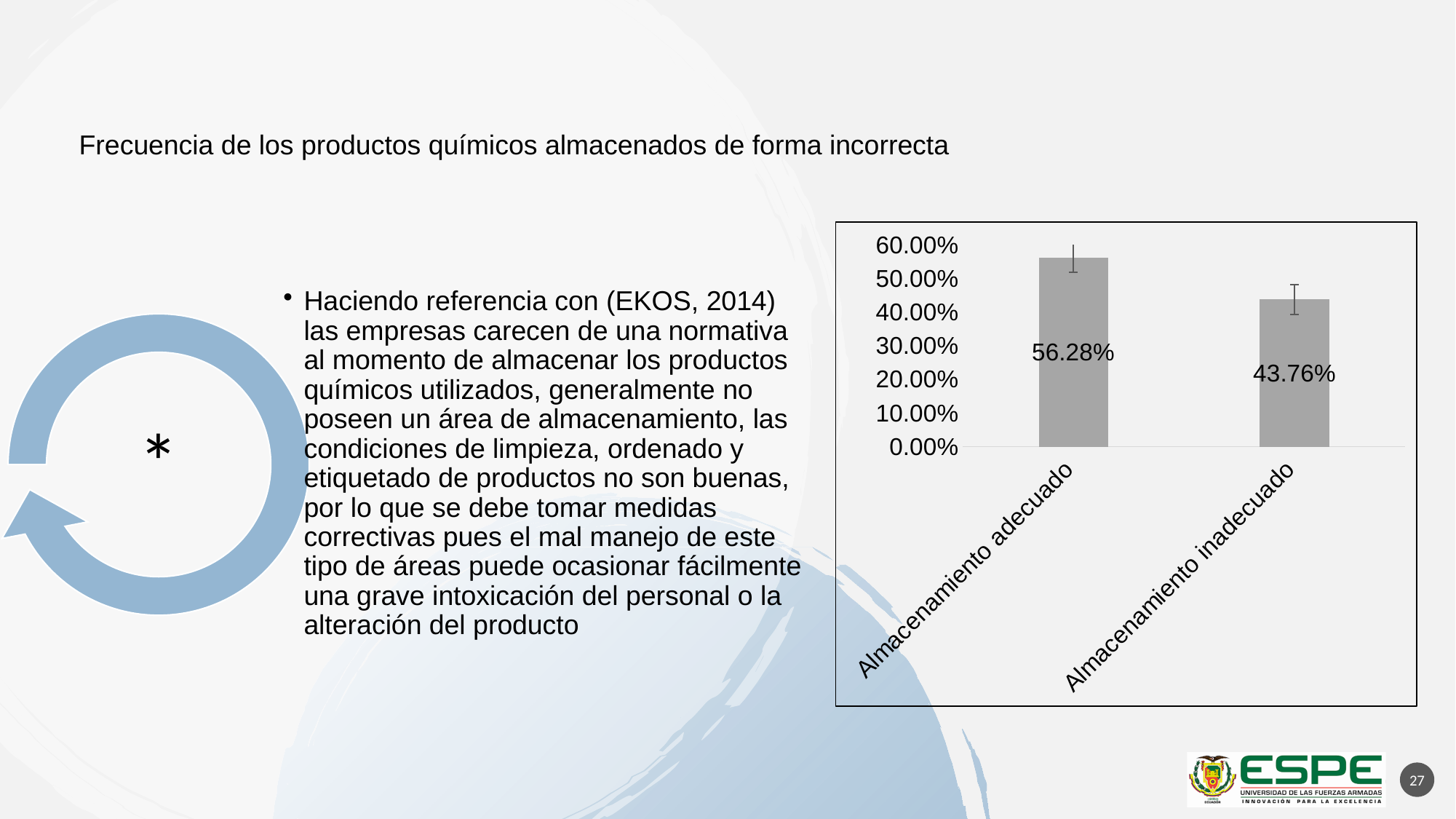
Which category has the highest value? Almacenamiento adecuado Is the value for Almacenamiento adecuado greater or less than 50.00%? greater Is the value for Almacenamiento inadecuado greater or less than 50.00%? less What is the value for Almacenamiento adecuado? 56.28% What kind of chart is shown on the slide? bar chart What is the value for Almacenamiento inadecuado? 43.76% Which is larger, the value for Almacenamiento adecuado or for Almacenamiento inadecuado? Almacenamiento adecuado What is the difference between the values for Almacenamiento adecuado and Almacenamiento inadecuado? 12.52% What colour are the bars in the chart? grey Which category has the lowest value? Almacenamiento inadecuado How many categories are shown in the chart? 2 What is the highest value shown on the vertical axis of the chart? 60.00%